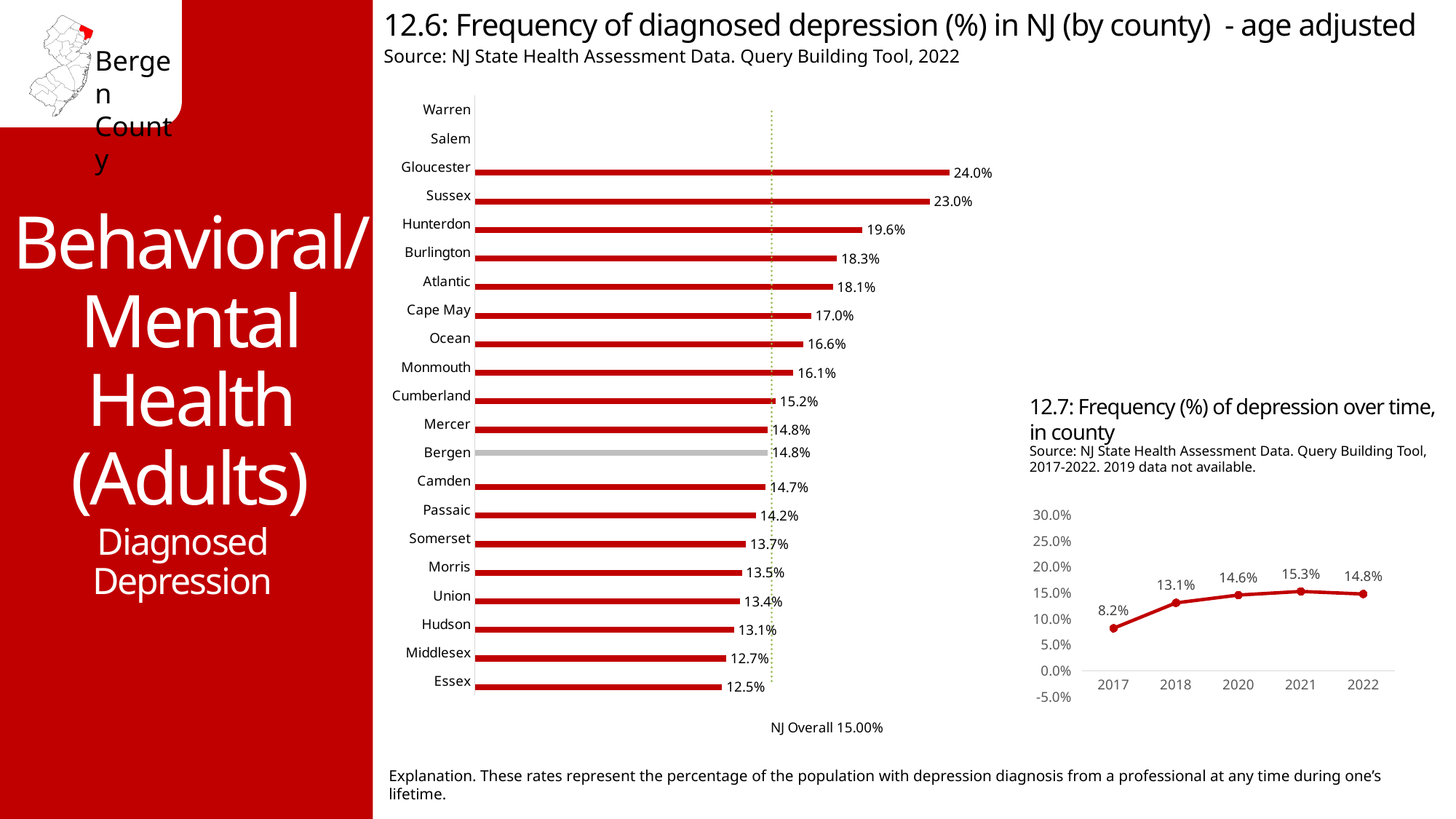
In chart 12.6, what is the NJ Overall value noted below the chart? 15.00% In chart 12.7, which year has the highest frequency of depression? 2021 In chart 12.6, what is the value shown for Gloucester? 24.0% What kind of chart is chart 12.6? Bar chart In chart 12.7, what was the frequency of depression in Bergen County in 2017? 8.2% In chart 12.6, what is the frequency of diagnosed depression for Bergen County? 14.8% In chart 12.6, which county has the highest frequency of diagnosed depression? Gloucester In chart 12.7, what is the difference between the 2022 value and the 2017 value? 6.6% In chart 12.6, what is the difference between the values for Sussex and Hunterdon? 3.4% In chart 12.7, how many years are plotted on the x axis? 5 In chart 12.6, which county has a higher value, Morris or Union? Morris In chart 12.6, which county with a plotted bar has the lowest frequency of diagnosed depression? Essex